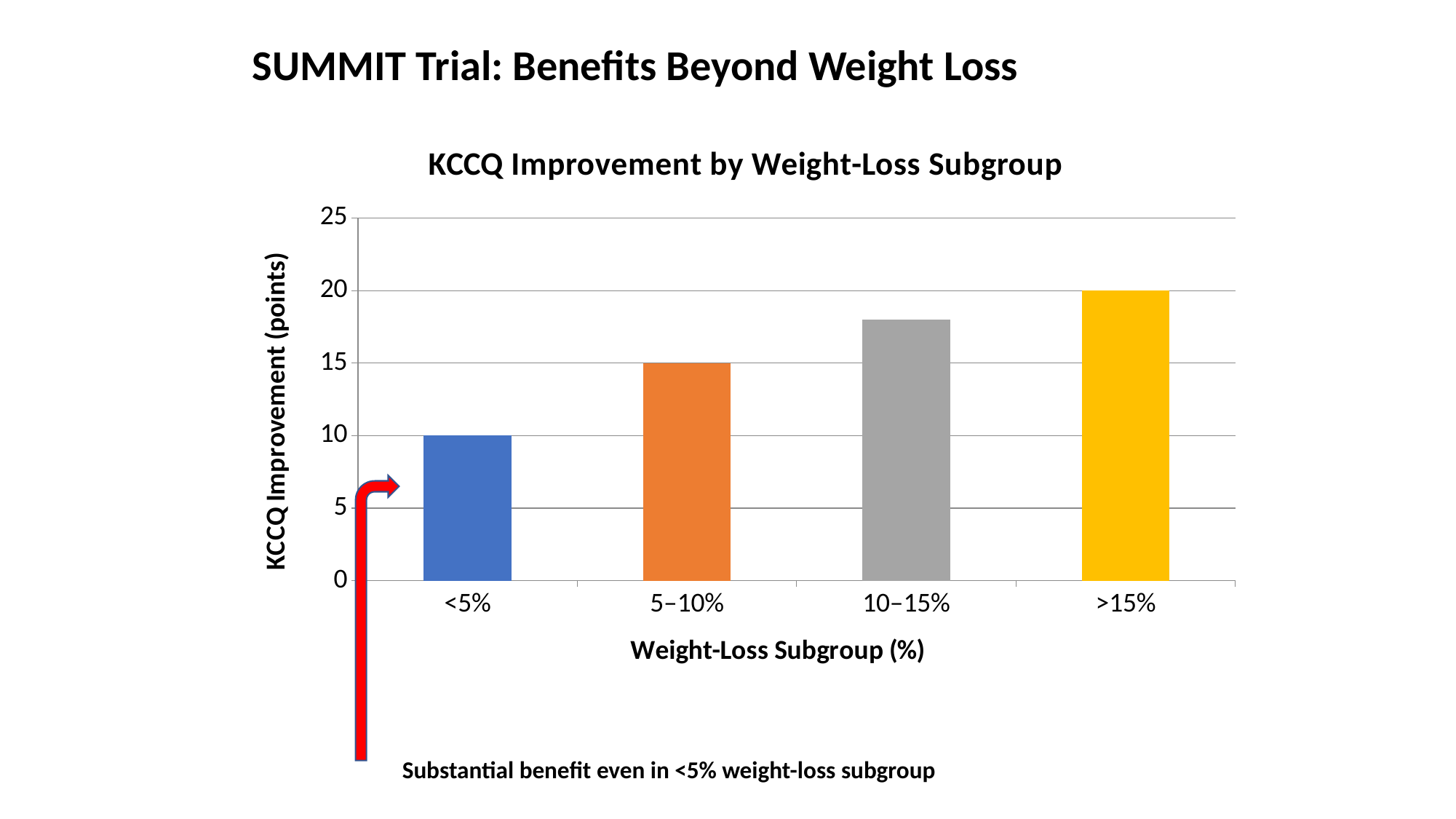
Is the KCCQ improvement for the 10–15% subgroup greater or less than 15? greater How many weight-loss subgroups are plotted on the chart? 4 Which weight-loss subgroup has the highest KCCQ improvement? >15% Do the KCCQ improvement values rise or fall as the weight-loss subgroup increases along the x axis? rise Which subgroup has a larger KCCQ improvement, 5–10% or 10–15%? 10–15% What is the KCCQ improvement for the 5–10% weight-loss subgroup? 15 What is the KCCQ improvement for the >15% weight-loss subgroup? 20 What is the chart's title? KCCQ Improvement by Weight-Loss Subgroup What type of chart is shown on the slide? bar chart What is the KCCQ improvement for the <5% weight-loss subgroup? 10 Which weight-loss subgroup has the lowest KCCQ improvement? <5% What is the difference in KCCQ improvement between the >15% and <5% subgroups? 10